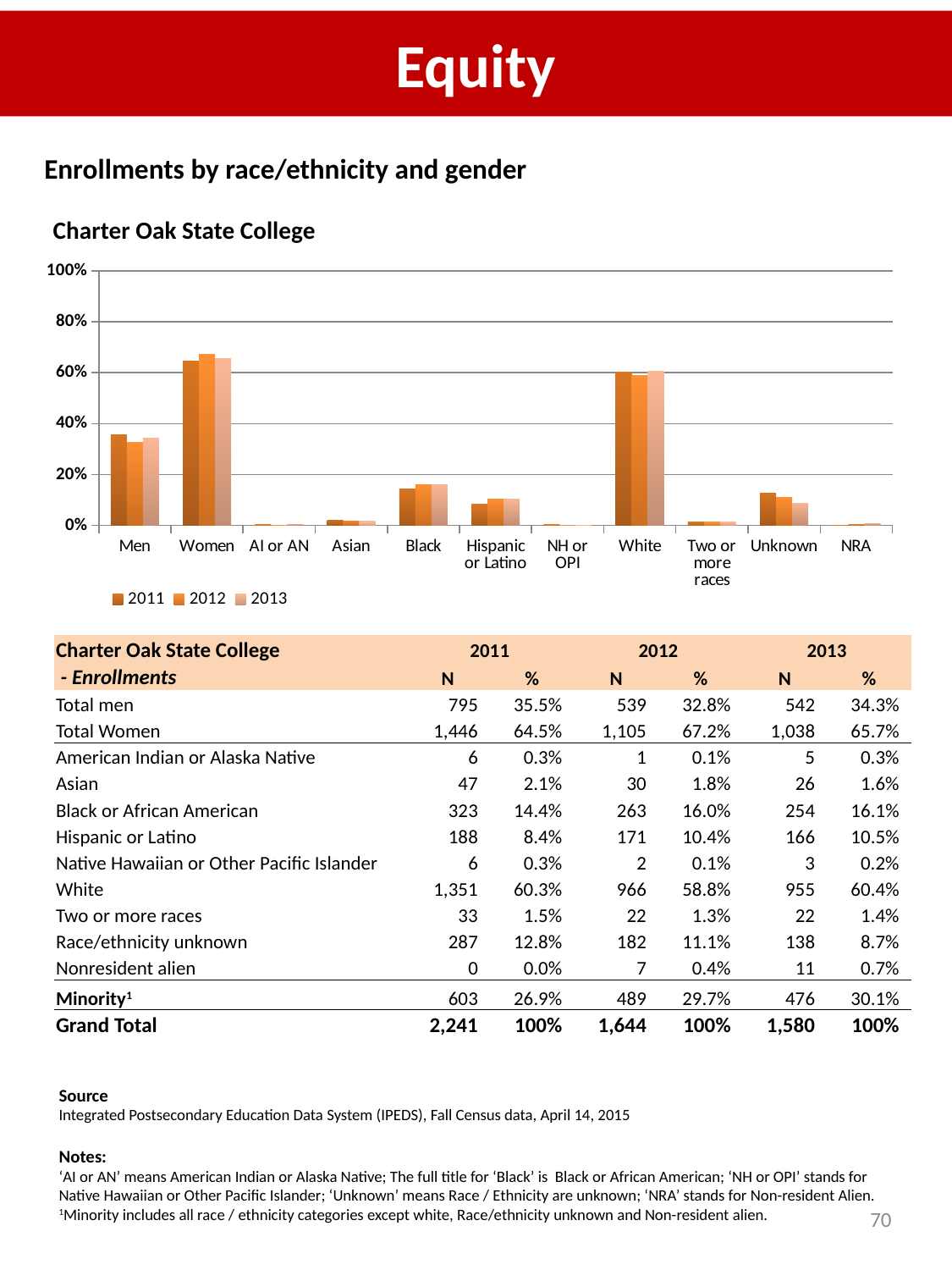
Which category has the highest value for 2012 in the chart? Women How many series does the chart legend list? 3 According to the table, what percentage of enrollments were White in 2013? 60.4% How many categories are shown along the x axis of the chart? 11 Does the value for Unknown rise or fall from 2011 to 2013? fall Is the value for Men in 2011 greater or less than 40%? less What kind of chart is shown on the slide? bar chart Which is larger in 2011, the value for Black or the value for Hispanic or Latino? Black Using the table values, what is the difference in percentage points between Total Women and Total men in 2012? 34.4 Is the value for Women in 2012 greater or less than 60%? greater According to the table, what percentage of enrollments were Black or African American in 2012? 16.0% What are the three years listed in the chart legend? 2011, 2012, 2013